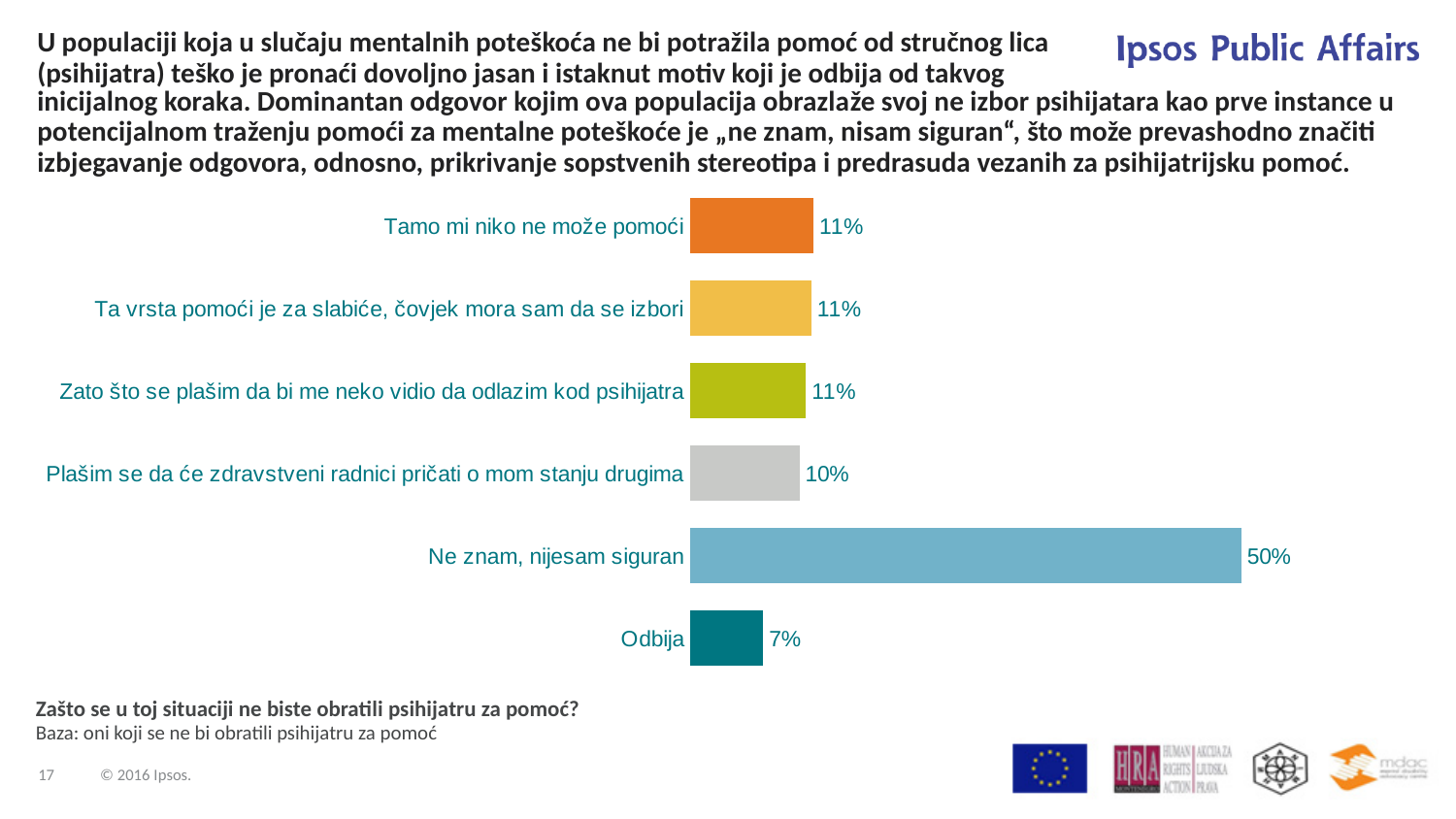
What colour is the bar for "Ne znam, nijesam siguran"? Blue What is the value for "Tamo mi niko ne može pomoći"? 11% What is the value for "Plašim se da će zdravstveni radnici pričati o mom stanju drugima"? 10% What is the difference between the values for "Zato što se plašim da bi me neko vidio da odlazim kod psihijatra" and "Plašim se da će zdravstveni radnici pričati o mom stanju drugima"? 1 percentage point Which category has the highest value? Ne znam, nijesam siguran Which is larger, the value for "Ne znam, nijesam siguran" or the value for "Ta vrsta pomoći je za slabiće, čovjek mora sam da se izbori"? Ne znam, nijesam siguran What is the value for "Ne znam, nijesam siguran"? 50% What is the difference between the values for "Ne znam, nijesam siguran" and "Odbija"? 43 percentage points Which category has the lowest value? Odbija What kind of chart is shown on the slide? Bar chart What is the value for "Odbija"? 7% How many categories are shown in the chart? 6